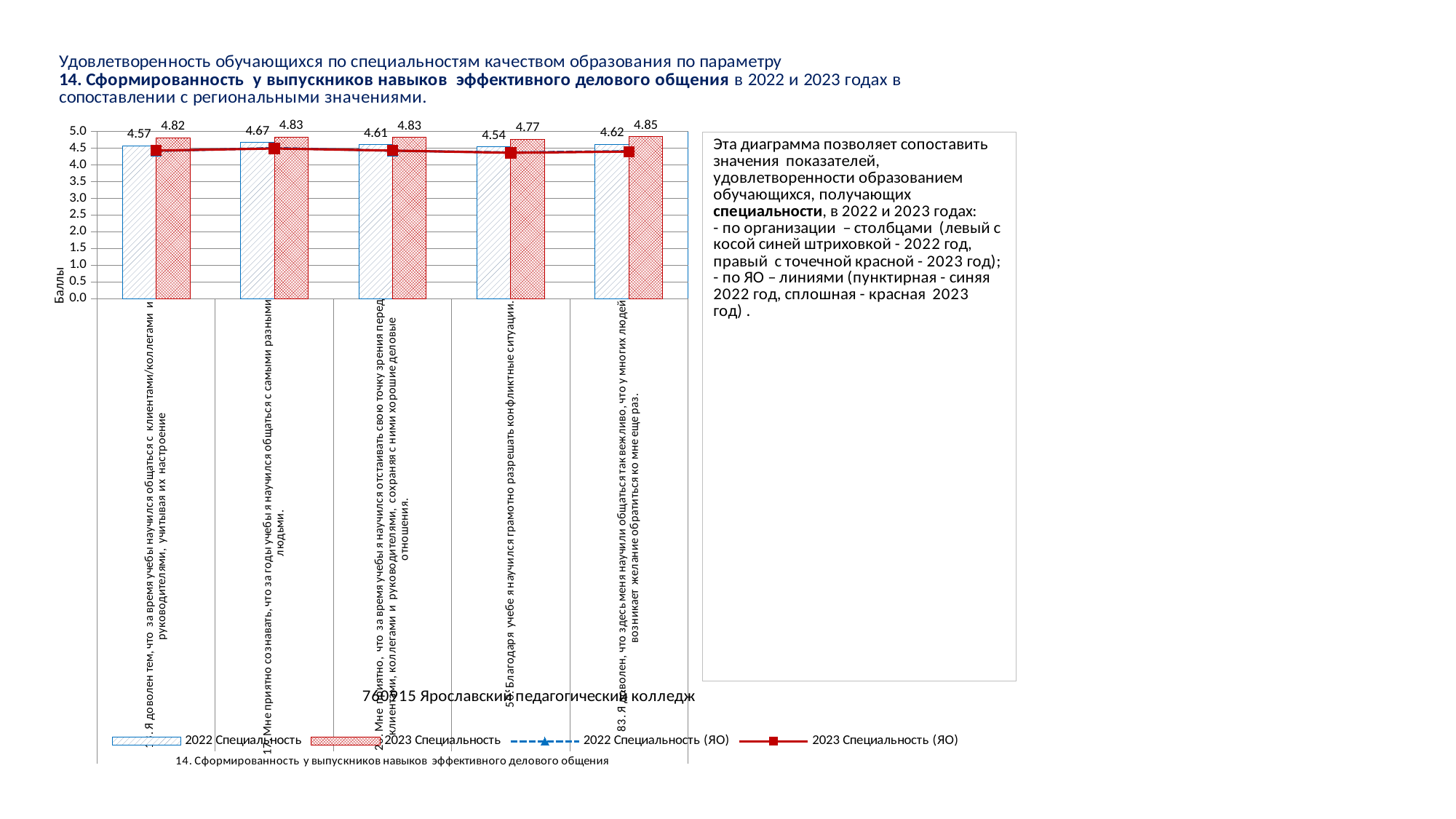
What type of chart is shown on the slide? Bar chart with lines What is the 2023 Специальность value for the category "Благодаря учебе я научился грамотно разрешать конфликтные ситуации"? 4.77 Which category has the lowest 2022 Специальность value? Благодаря учебе я научился грамотно разрешать конфликтные ситуации (4.54) Is the 2023 Специальность (ЯО) line value for the first category greater or less than 4.0? greater How many series does the chart legend list? 4 Which category has the highest 2023 Специальность value? Я доволен, что здесь меня научили общаться так вежливо, что у многих людей возникает желание обратиться ко мне еще раз (4.85) What is the difference between the 2023 and 2022 Специальность values for the first category? 0.25 What is the 2022 Специальность value for the first category ("Я доволен тем, что за время учебы научился общаться с клиентами/коллегами и руководителями...")? 4.57 How many categories are plotted along the x axis of the chart? 5 What is the label of the vertical axis of the chart? Баллы What is the 2023 Специальность value for the last category ("Я доволен, что здесь меня научили общаться так вежливо...")? 4.85 For the second category ("Мне приятно сознавать, что за годы учебы я научился общаться с самыми разными людьми"), which is larger: the 2022 Специальность value or the 2023 Специальность value? 2023 Специальность (4.83)